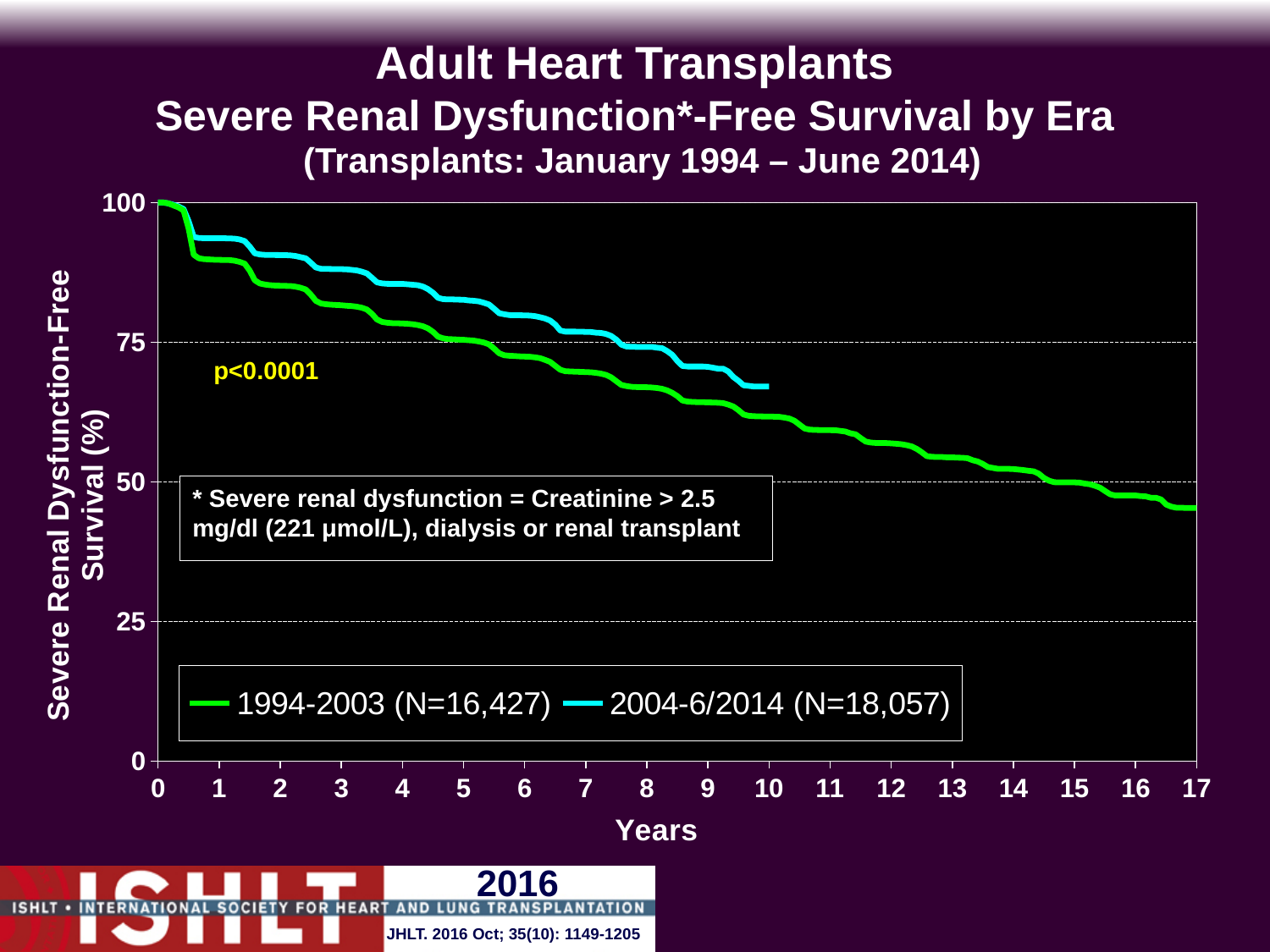
Is the severe renal dysfunction-free survival for the 1994-2003 era at 10 years greater or less than 75? less At 5 years, which era has the higher severe renal dysfunction-free survival, 1994-2003 or 2004-6/2014? 2004-6/2014 Is the severe renal dysfunction-free survival for the 1994-2003 era at 17 years greater or less than 50? less Which era does the green line represent? 1994-2003 (N=16,427) How many series does the legend list? 2 Do the survival curves rise or fall as years since transplant increase? fall What kind of chart is shown on the slide? line chart Is the severe renal dysfunction-free survival for the 2004-6/2014 era at 5 years greater or less than 75? greater What is the sample size (N) for the 2004-6/2014 era shown in the legend? 18,057 Which era's curve extends to 17 years on the x axis? 1994-2003